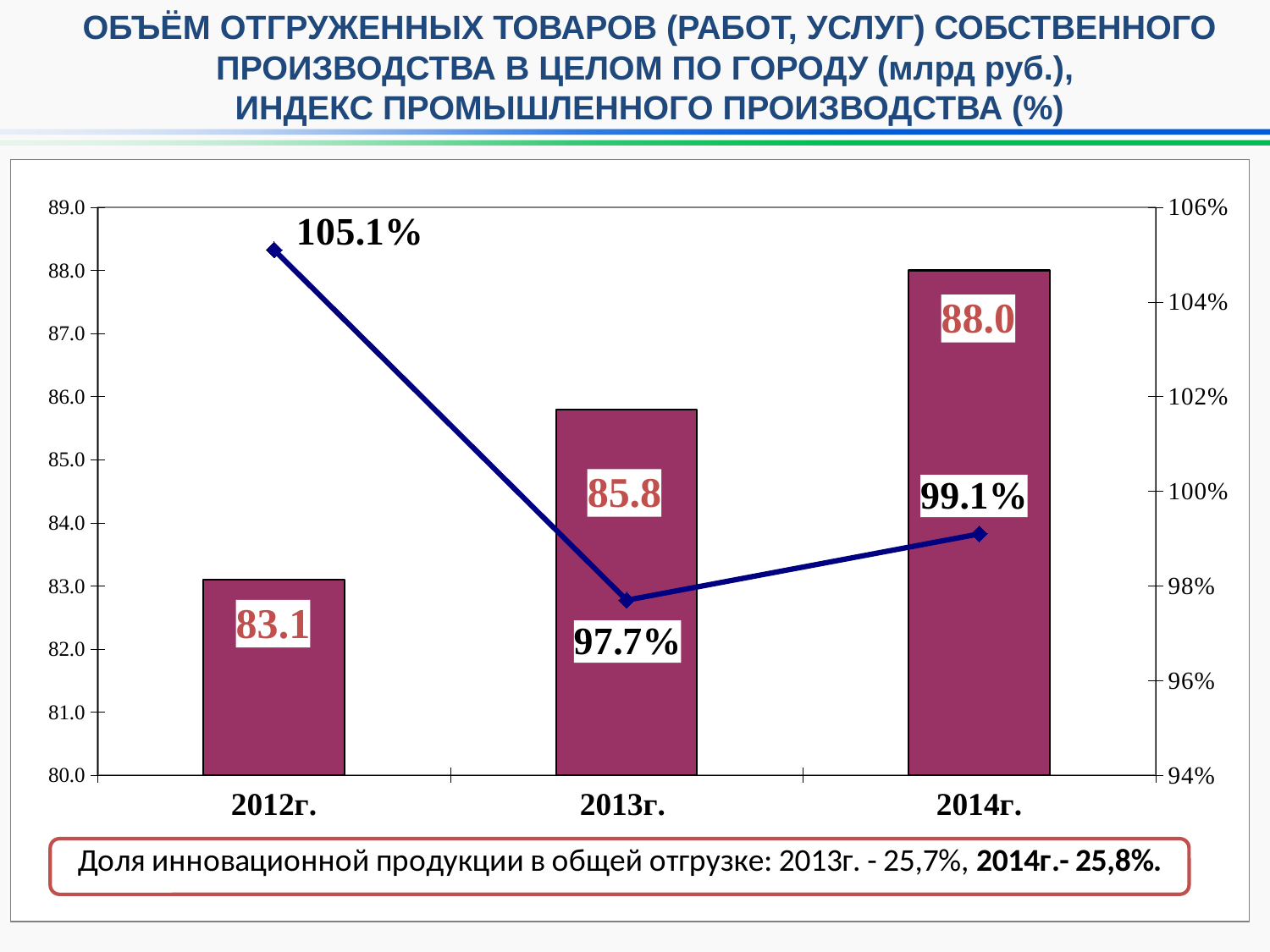
Which year has the highest bar value? 2014г. Which is larger, the bar value for 2012г. or for 2013г.? 2013г. What is the difference between the bar values for 2014г. and 2012г.? 4.9 Which year has the lowest industrial production index on the line? 2013г. Do the bar values rise or fall from 2012г. to 2014г.? rise What kind of chart is shown on the slide? Combined bar and line chart What is the difference between the industrial production index for 2012г. and 2013г.? 7.4% What is the industrial production index (line value) for 2012г.? 105.1% What is the bar value for 2014г.? 88.0 What is the volume of shipped goods (bar value) for 2013г.? 85.8 How many years are shown on the x axis? 3 What is the industrial production index for 2014г.? 99.1%